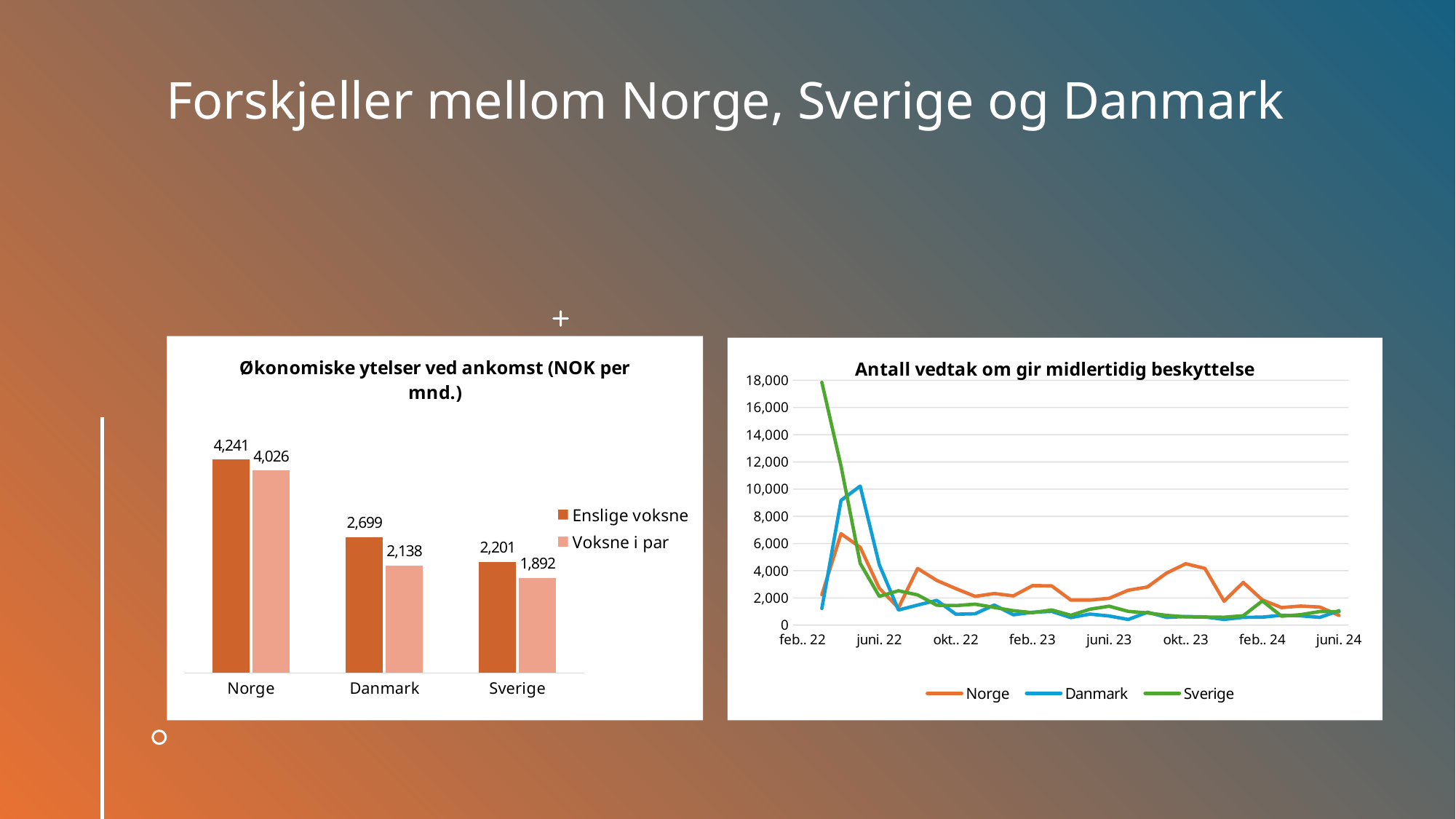
In the chart titled "Antall vedtak om gir midlertidig beskyttelse", is the peak value of the Sverige line greater or less than 16,000? greater In the chart titled "Økonomiske ytelser ved ankomst (NOK per mnd.)", which country has the highest value for Enslige voksne? Norge How many series does the legend of the chart titled "Antall vedtak om gir midlertidig beskyttelse" list? 3 What kind of chart is the chart titled "Antall vedtak om gir midlertidig beskyttelse"? Line chart In the chart titled "Økonomiske ytelser ved ankomst (NOK per mnd.)", how many countries are shown on the x axis? 3 In the chart titled "Økonomiske ytelser ved ankomst (NOK per mnd.)", what is the value for Voksne i par in Sverige? 1,892 In the chart titled "Økonomiske ytelser ved ankomst (NOK per mnd.)", what is the difference between Enslige voksne and Voksne i par in Danmark? 561 In the chart titled "Økonomiske ytelser ved ankomst (NOK per mnd.)", what is the value for Enslige voksne in Norge? 4,241 What kind of chart is the chart titled "Økonomiske ytelser ved ankomst (NOK per mnd.)"? Bar chart In the chart titled "Økonomiske ytelser ved ankomst (NOK per mnd.)", which is larger: Voksne i par in Danmark or Enslige voksne in Sverige? Enslige voksne in Sverige In the chart titled "Økonomiske ytelser ved ankomst (NOK per mnd.)", which country has the lowest value for Voksne i par? Sverige In the chart titled "Antall vedtak om gir midlertidig beskyttelse", is the peak value of the Danmark line greater or less than 12,000? less